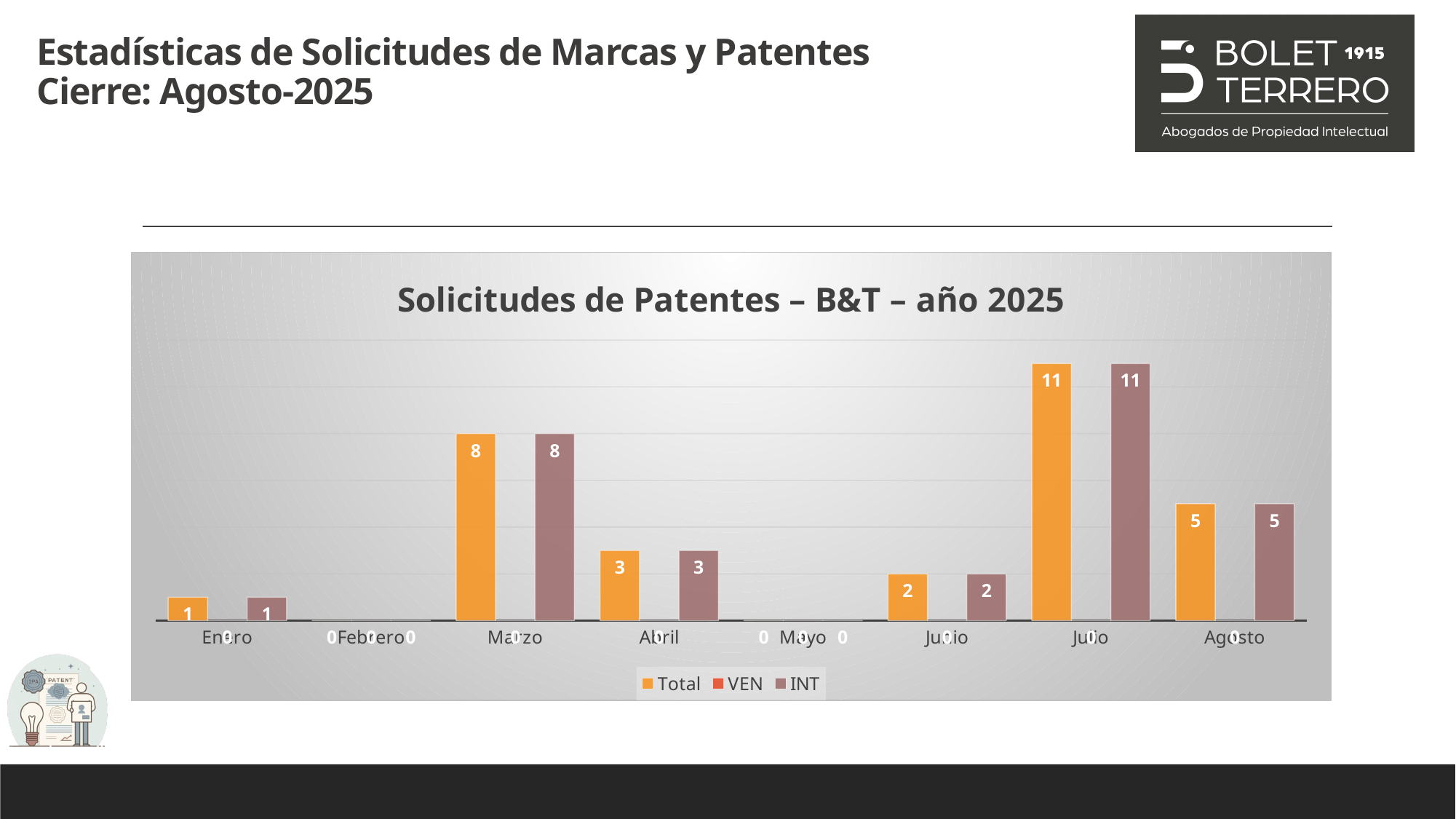
What is the Total value for Febrero? 0 What is the INT value for Marzo? 8 What is the INT value for Junio? 2 What is the difference between the Total values for Julio and Marzo? 3 What is the Total value for Agosto? 5 How many months are shown on the x axis? 8 Which month has the highest Total value? Julio What is the title of the chart? Solicitudes de Patentes – B&T – año 2025 Which is larger, the Total value for Abril or the Total value for Agosto? Agosto What kind of chart is shown? Bar chart What is the Total value for Julio? 11 How many series does the legend list? 3